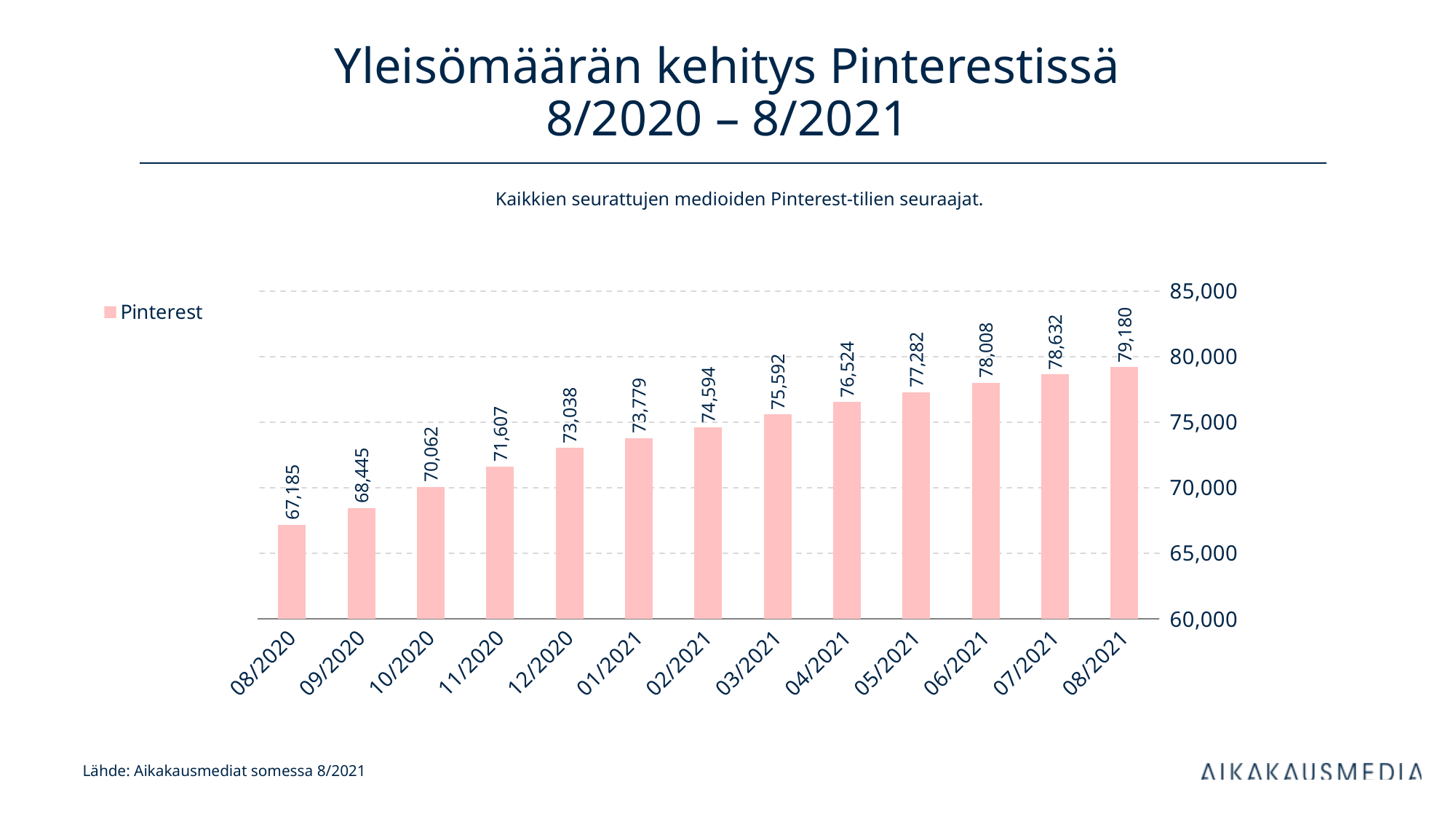
Which month has the highest value? 08/2021 What kind of chart is shown on the slide? bar chart What is the value for 08/2021? 79,180 What is the value for 03/2021? 75,592 Which is larger, the value for 05/2021 or the value for 02/2021? 05/2021 Which month has the lowest value? 08/2020 Do the values rise or fall from 08/2020 to 08/2021? rise What is the difference between the values for 12/2020 and 11/2020? 1,431 What is the difference between the values for 08/2021 and 08/2020? 11,995 Is the value for 10/2020 greater or less than 75,000? less What is the value for 08/2020? 67,185 How many months are shown on the x axis? 13